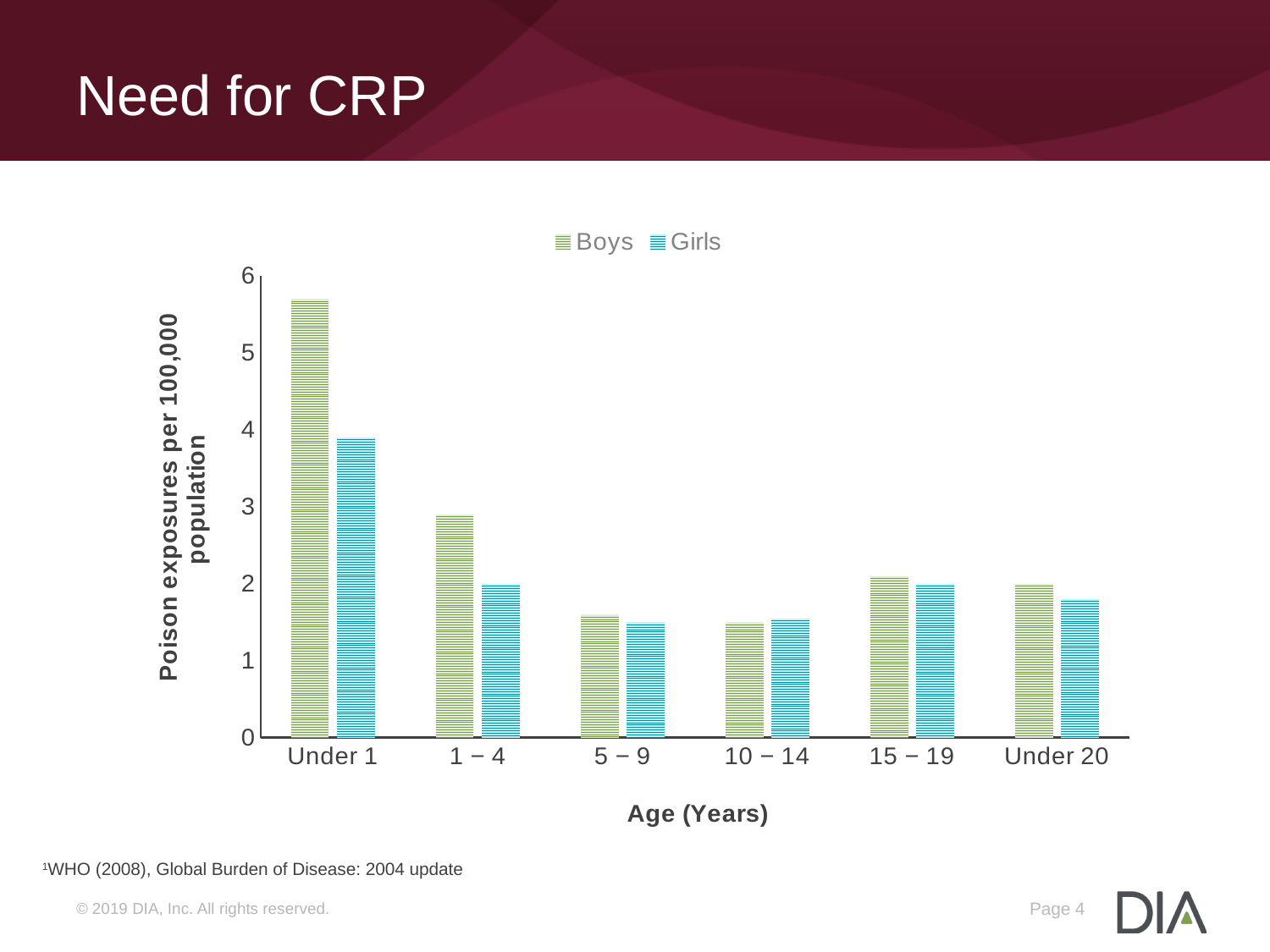
How many age categories are shown on the x axis? 6 Which is larger in the Under 1 category, the value for Boys or for Girls? Boys Is the value for Girls in the 5 – 9 category greater or less than 2? less Which is larger in the 1 – 4 category, the value for Boys or for Girls? Boys Which age category has the highest value for Girls? Under 1 Is the value for Boys in the Under 1 category greater or less than 5? greater How many series does the legend list? 2 What is the title of the y axis? Poison exposures per 100,000 population What kind of chart is shown on the slide? bar chart Which age category has the highest value for Boys? Under 1